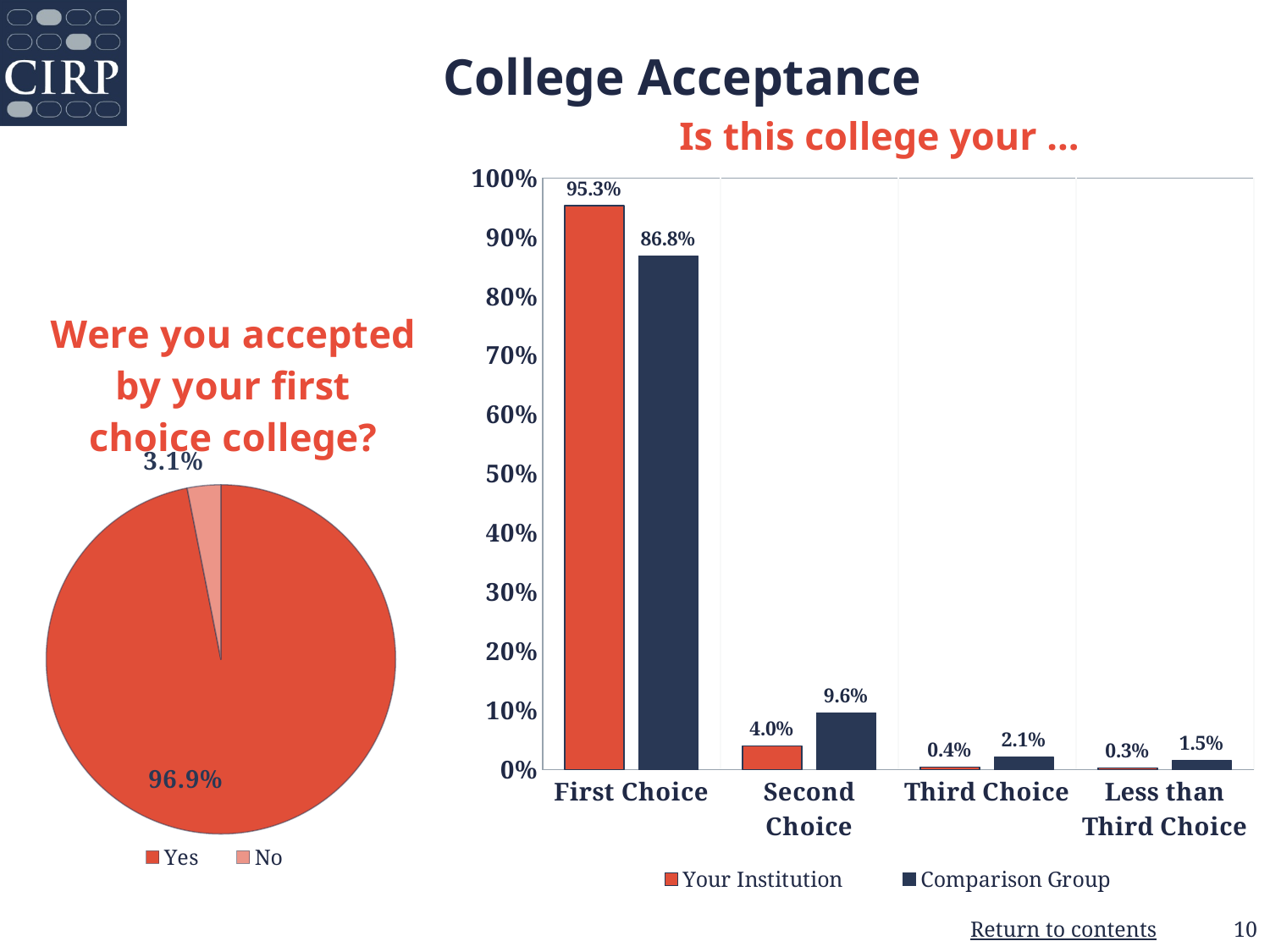
In the 'Is this college your ...' bar chart, which is larger for Third Choice: Your Institution or Comparison Group? Comparison Group What kind of chart is the 'Were you accepted by your first choice college?' chart? Pie chart In the 'Is this college your ...' bar chart, what is the value for Comparison Group for Second Choice? 9.6% In the 'Is this college your ...' bar chart, how many categories are shown on the x axis? 4 In the 'Is this college your ...' bar chart, what is the value for Your Institution for First Choice? 95.3% In the 'Were you accepted by your first choice college?' pie chart, what is the value for No? 3.1% In the 'Were you accepted by your first choice college?' pie chart, what share of the pie is Yes? 96.9% In the 'Is this college your ...' bar chart, which category has the lowest value for Comparison Group? Less than Third Choice In the 'Is this college your ...' bar chart, which category has the highest value for Your Institution? First Choice In the 'Is this college your ...' bar chart, what is the difference between Your Institution and Comparison Group for First Choice? 8.5% In the 'Is this college your ...' bar chart, what is the value for Comparison Group for Less than Third Choice? 1.5% In the 'Is this college your ...' bar chart, how many series does the legend list? 2